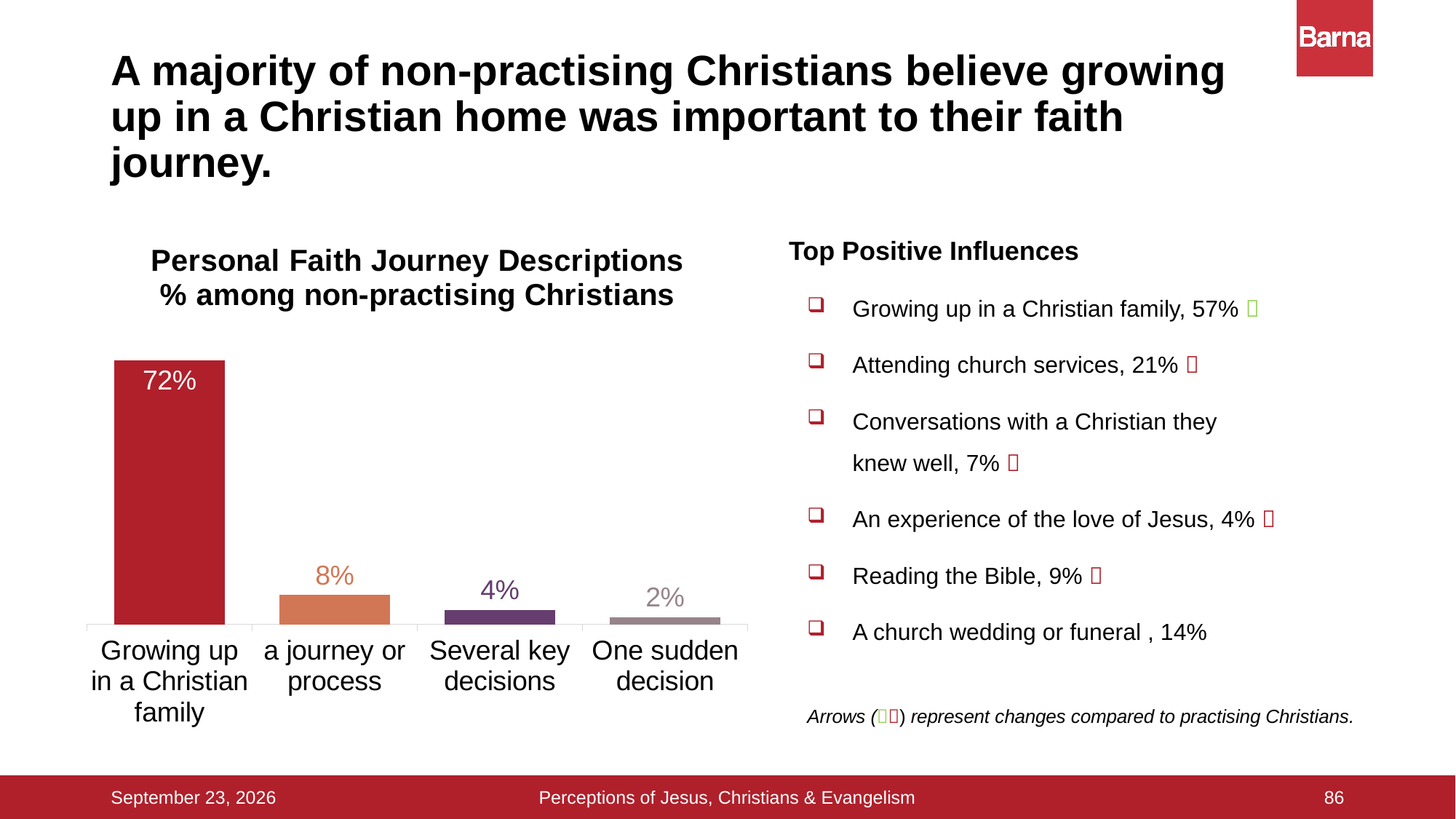
How many categories are shown in the chart? 4 Which is larger, 'a journey or process' or 'Several key decisions'? a journey or process What is the value for 'One sudden decision'? 2% What kind of chart is shown? Bar chart Which category has the highest value? Growing up in a Christian family What is the value for 'a journey or process'? 8% Which category has the lowest value? One sudden decision What is the title of the chart? Personal Faith Journey Descriptions % among non-practising Christians What is the value for 'Growing up in a Christian family'? 72% What is the difference between 'Growing up in a Christian family' and 'a journey or process'? 64% What is the value for 'Several key decisions'? 4% What is the difference between 'Several key decisions' and 'One sudden decision'? 2%